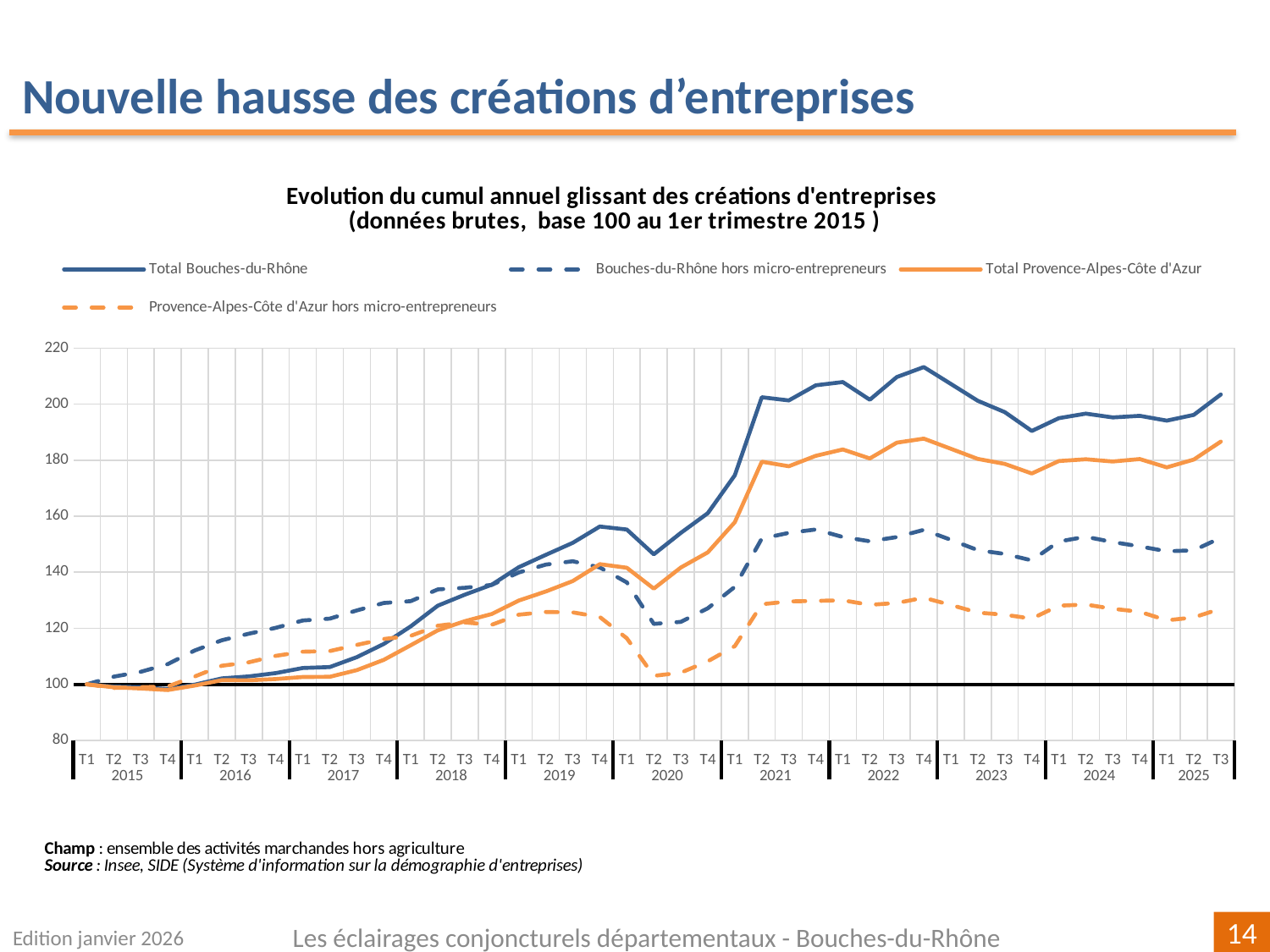
What kind of chart is shown on the slide? line chart Is the value for Bouches-du-Rhône hors micro-entrepreneurs at T3 2025 greater or less than 140? greater What is the value of the Total Bouches-du-Rhône series at T1 2015? 100 Which series has the lowest value at T3 2025? Provence-Alpes-Côte d'Azur hors micro-entrepreneurs How many series does the legend list? 4 Is the value for Total Bouches-du-Rhône at T3 2025 greater or less than 200? greater Is the value for Total Provence-Alpes-Côte d'Azur at T3 2025 greater or less than 200? less Does the Total Bouches-du-Rhône series rise or fall overall from T1 2015 to T3 2025? rise How many years are labelled along the x axis? 11 At T3 2025, which is larger: Total Bouches-du-Rhône or Total Provence-Alpes-Côte d'Azur? Total Bouches-du-Rhône Which series has the highest value at T3 2025? Total Bouches-du-Rhône